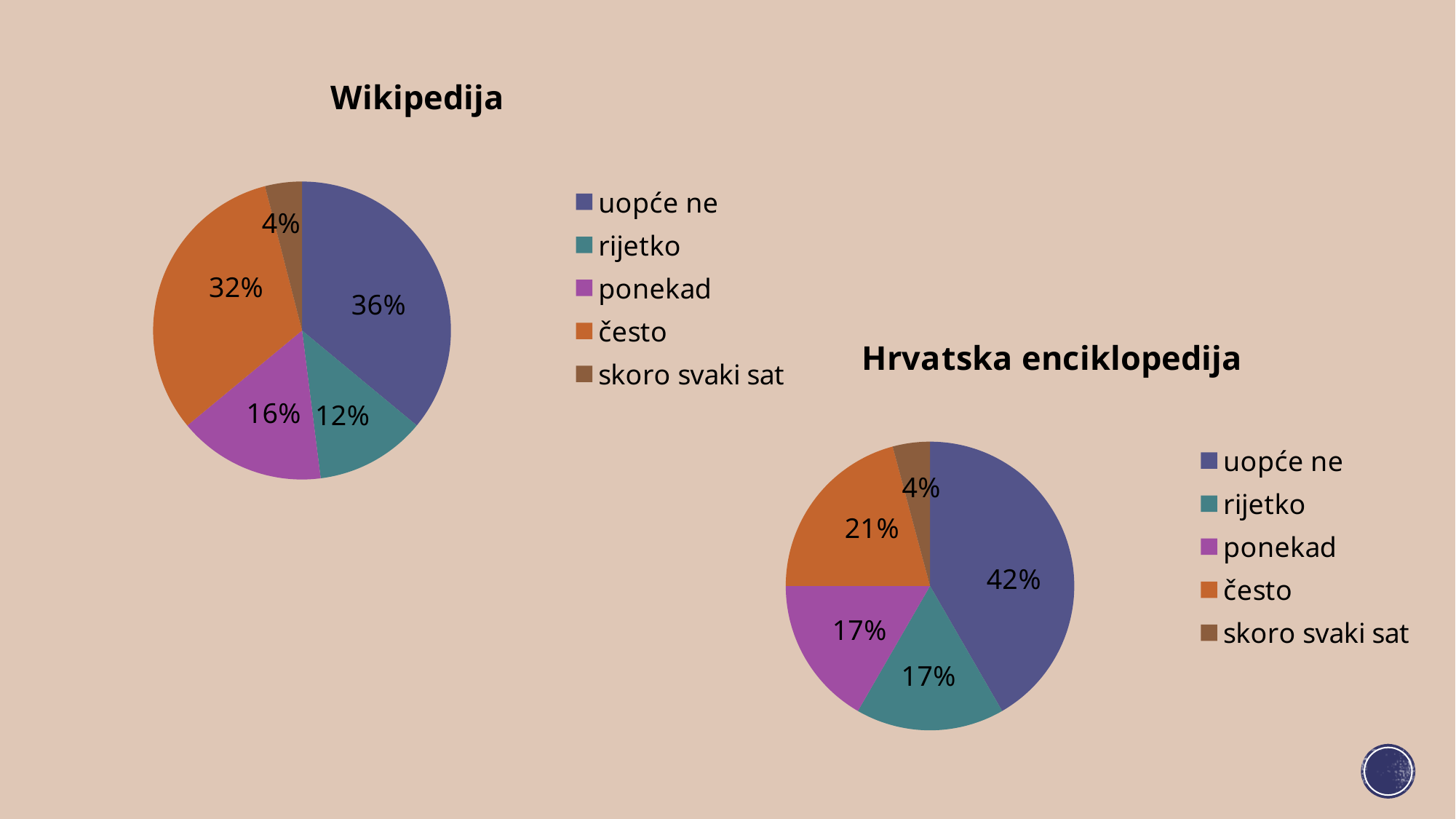
In the Wikipedija chart, what share does the 'često' slice have? 32% In the Wikipedija chart, which category has the largest slice? uopće ne What type of chart is the Hrvatska enciklopedija chart? pie chart Which chart has the larger 'rijetko' slice, Wikipedija or Hrvatska enciklopedija? Hrvatska enciklopedija How many slices does the Wikipedija chart have? 5 In the Wikipedija chart, which category has the smallest slice? skoro svaki sat In the Hrvatska enciklopedija chart, what is the difference between the 'uopće ne' and 'često' slices? 21% In the Wikipedija chart, what is the difference between the 'često' and 'ponekad' slices? 16% In the Hrvatska enciklopedija chart, what share does the 'uopće ne' slice have? 42% In the Hrvatska enciklopedija chart, which category has the smallest slice? skoro svaki sat In the Wikipedija chart, what share does the 'uopće ne' slice have? 36% In the Hrvatska enciklopedija chart, what share does the 'često' slice have? 21%